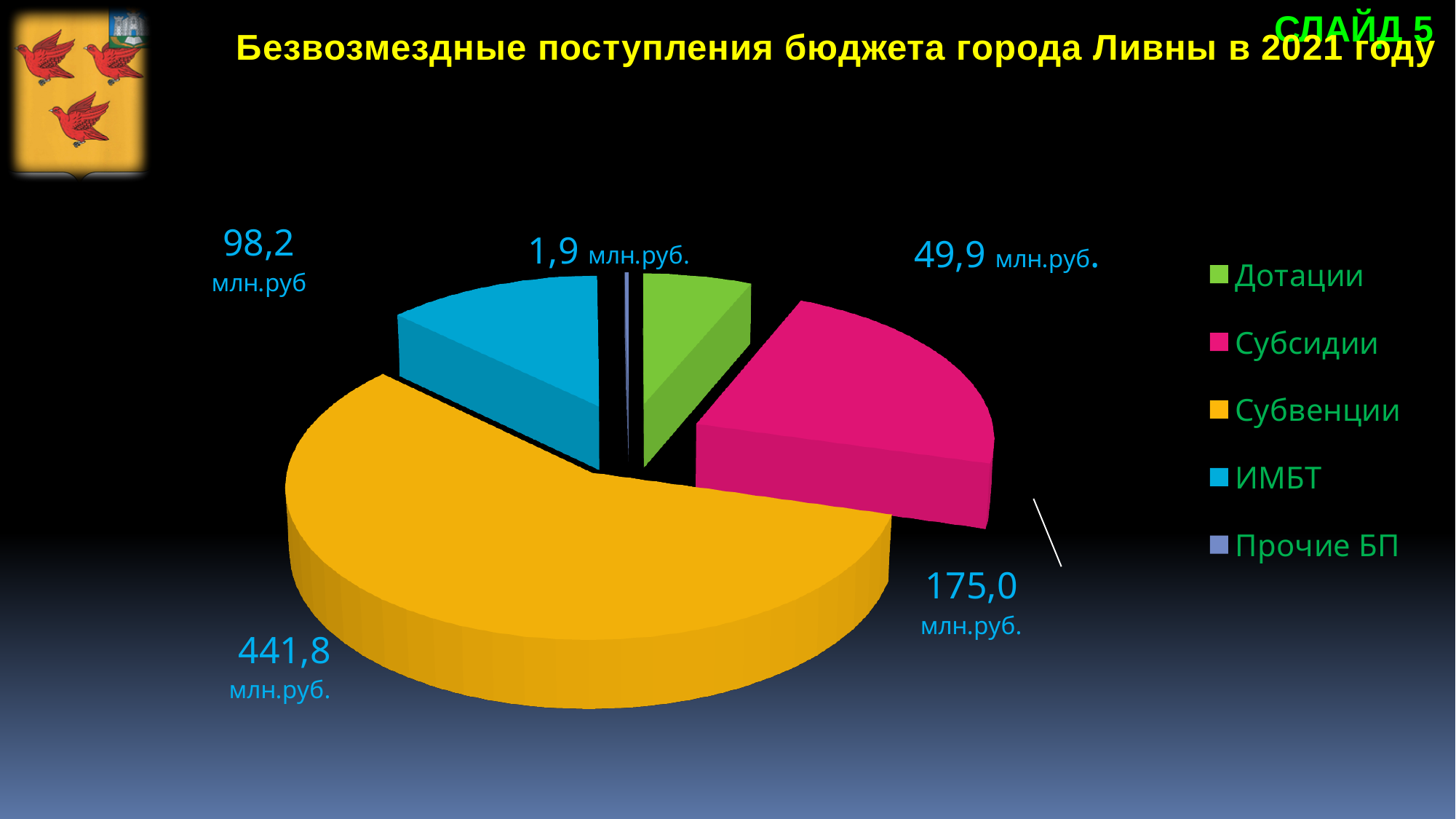
What is the value for Прочие БП? 1,9 млн.руб. How many categories does the legend list? 5 Which category has the largest value? Субвенции Which category has the smallest value? Прочие БП What is the difference between the values for Субвенции and Субсидии? 266,8 млн.руб. What is the value for Субсидии? 175,0 млн.руб. What is the value for Субвенции? 441,8 млн.руб. What colour represents Субсидии in the chart? Pink Which is larger, the value for ИМБТ or the value for Дотации? ИМБТ What is the value for ИМБТ? 98,2 млн.руб What is the value for Дотации? 49,9 млн.руб. What type of chart is shown on the slide? Pie chart